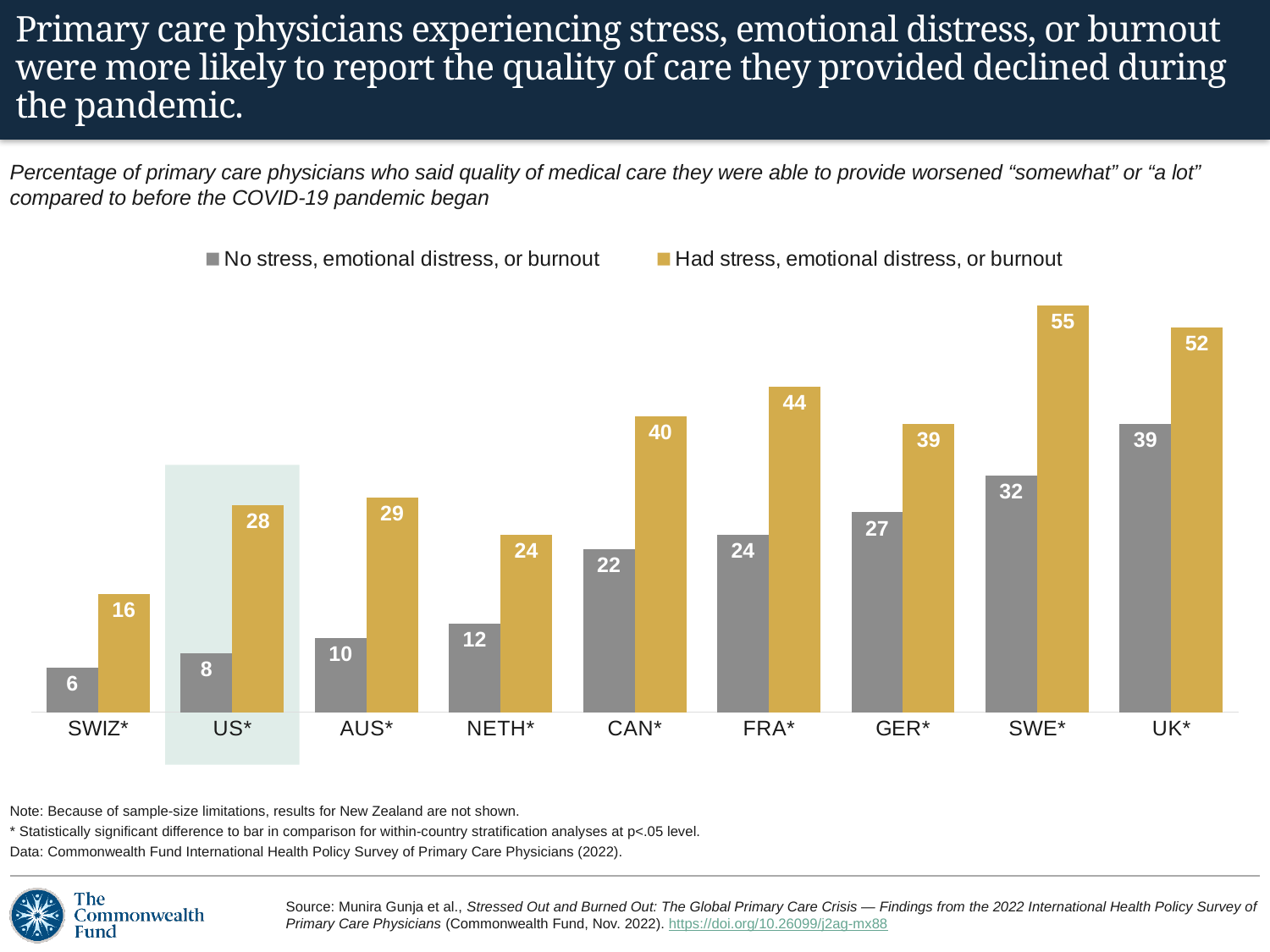
Which is larger: the 'No stress' value for UK* or the 'Had stress' value for GER*? They are equal (39) What is the difference between the 'Had stress' and 'No stress' values for SWIZ*? 10 What is the value for FRA* in the 'Had stress, emotional distress, or burnout' series? 44 Which country has the highest value in the 'Had stress, emotional distress, or burnout' series? SWE* What kind of chart is shown on the slide? Bar chart What is the value for SWE* in the 'No stress, emotional distress, or burnout' series? 32 What is the difference between the 'Had stress' and 'No stress' values for SWE*? 23 Which country has the lowest value in the 'No stress, emotional distress, or burnout' series? SWIZ* Which is larger: the 'Had stress' value for CAN* or the 'Had stress' value for AUS*? CAN* How many series does the legend list? 2 How many countries are shown on the x axis? 9 What is the value for US* in the 'Had stress, emotional distress, or burnout' series? 28